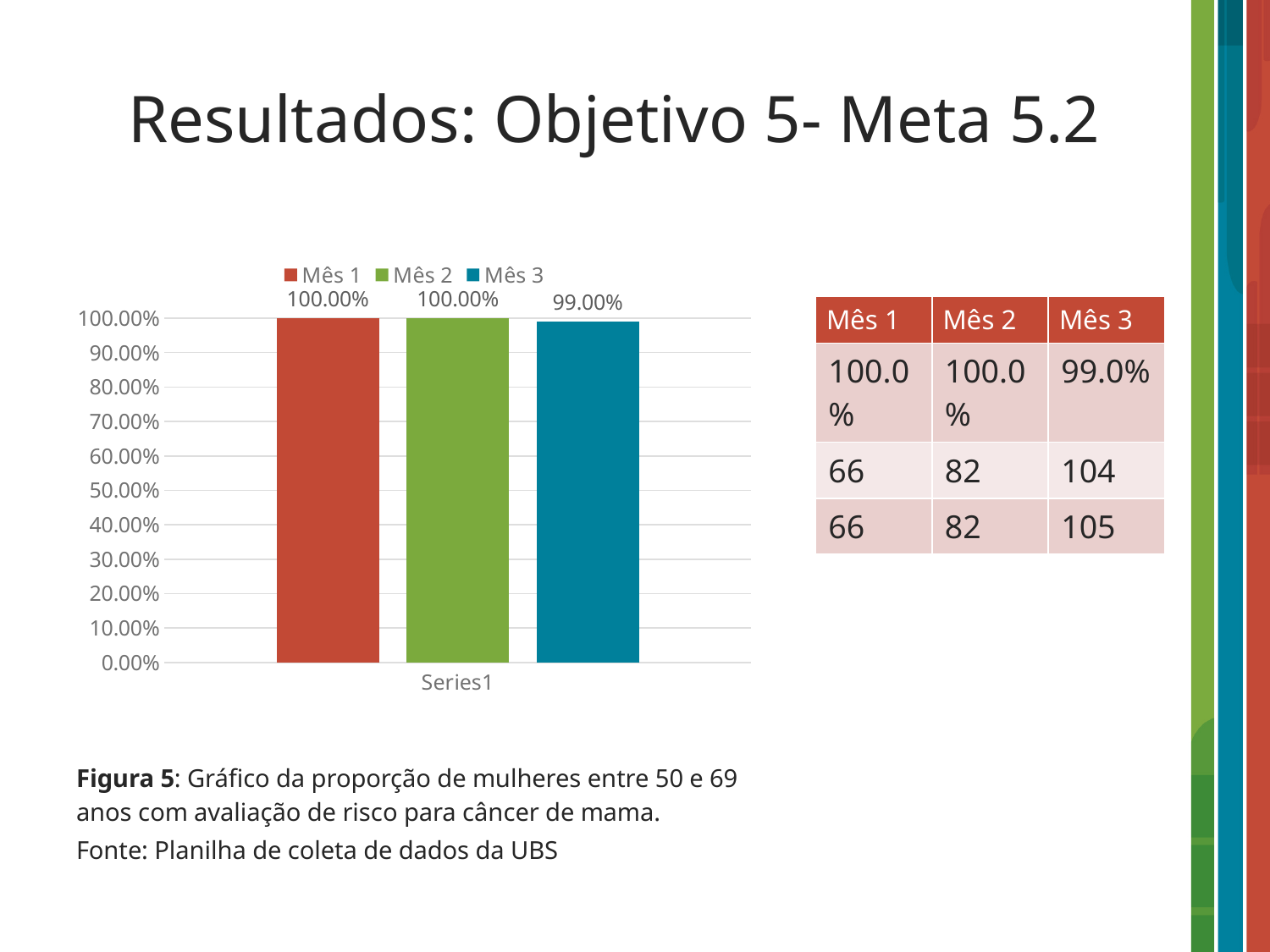
What is the value shown for Mês 3 in the chart? 99.00% What is the value shown for Mês 1 in the chart? 100.00% How many series does the legend list? 3 What is the difference between the values for Mês 1 and Mês 3? 1.00% Is the value for Mês 3 greater or less than 90.00%? greater Which is larger, the value for Mês 2 or the value for Mês 3? Mês 2 What colour is the bar for Mês 3 in the chart? blue What is the value shown for Mês 2 in the chart? 100.00% What kind of chart is shown on the slide? bar chart Which series has the lowest value in the chart? Mês 3 What is the category label shown on the x axis of the chart? Series1 How many bars are plotted in the chart? 3